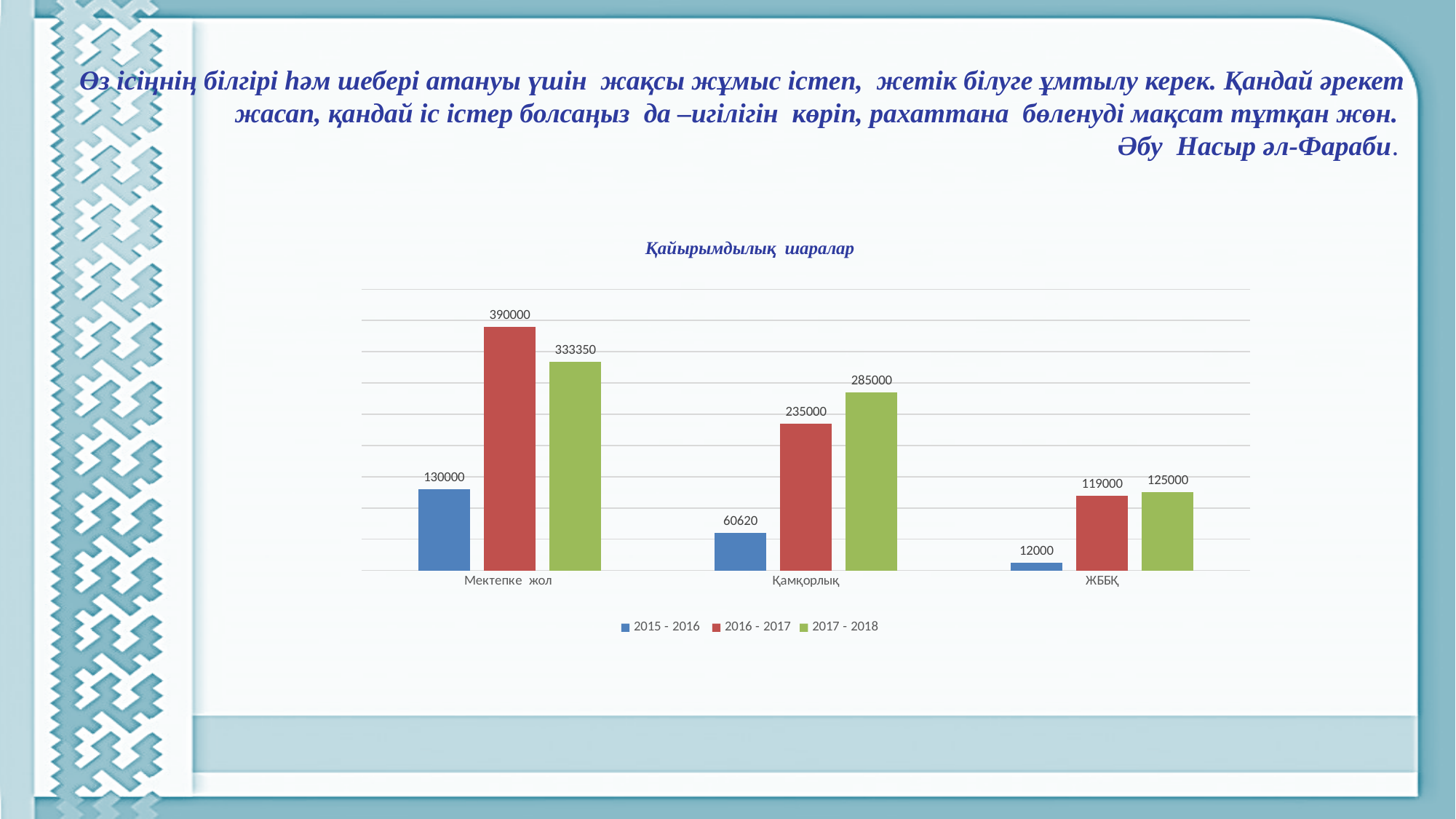
What is the value for Мектепке жол in the 2016 - 2017 series? 390000 How many categories are shown on the x axis? 3 Which is larger for Мектепке жол: the 2016 - 2017 value or the 2017 - 2018 value? 2016 - 2017 What is the difference between the 2016 - 2017 and 2017 - 2018 values for Қамқорлық? 50000 What kind of chart is shown on the slide? bar chart Which category has the highest value in the 2017 - 2018 series? Мектепке жол What is the value for Қамқорлық in the 2015 - 2016 series? 60620 Which category has the lowest value in the 2015 - 2016 series? ЖББҚ What is the title of the chart? Қайырымдылық шаралар How many series does the legend list? 3 What is the value for ЖББҚ in the 2017 - 2018 series? 125000 Do the 2015 - 2016 values rise or fall from Мектепке жол to ЖББҚ? fall